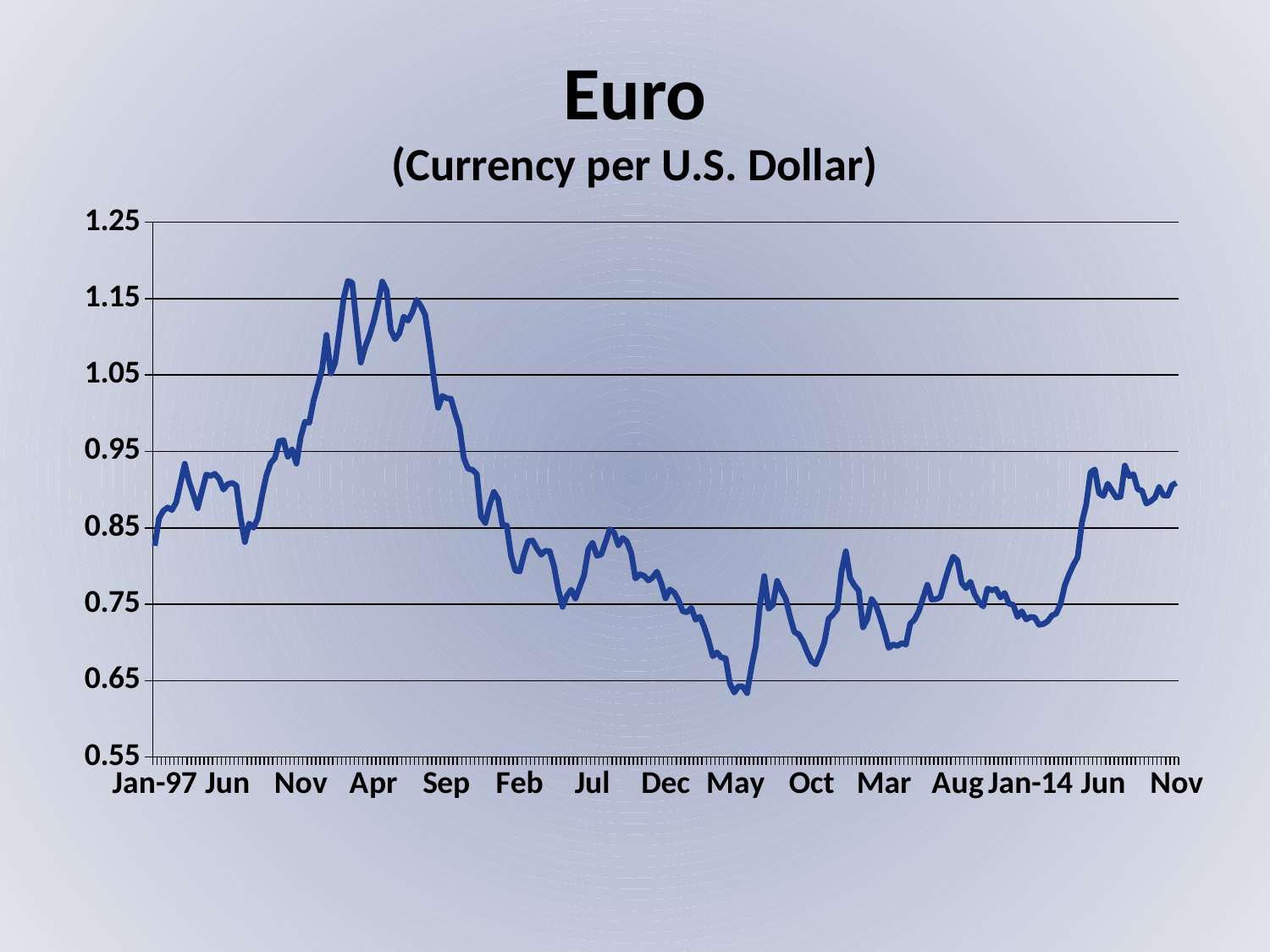
Is the value at Apr (the peak region) greater or less than 1.05? greater Does the line rise or fall between Jan-14 and Jun? rise How many labels are shown along the x axis? 15 Is the value at Feb greater or less than 0.85? less Is the value at the final Nov label greater or less than 0.85? greater How many lines are plotted on the chart? 1 What is the title of the chart? Euro What kind of chart is shown on the slide? line chart What unit does the chart's subtitle say the values are in? Currency per U.S. Dollar Does the line rise or fall between Apr and May? fall